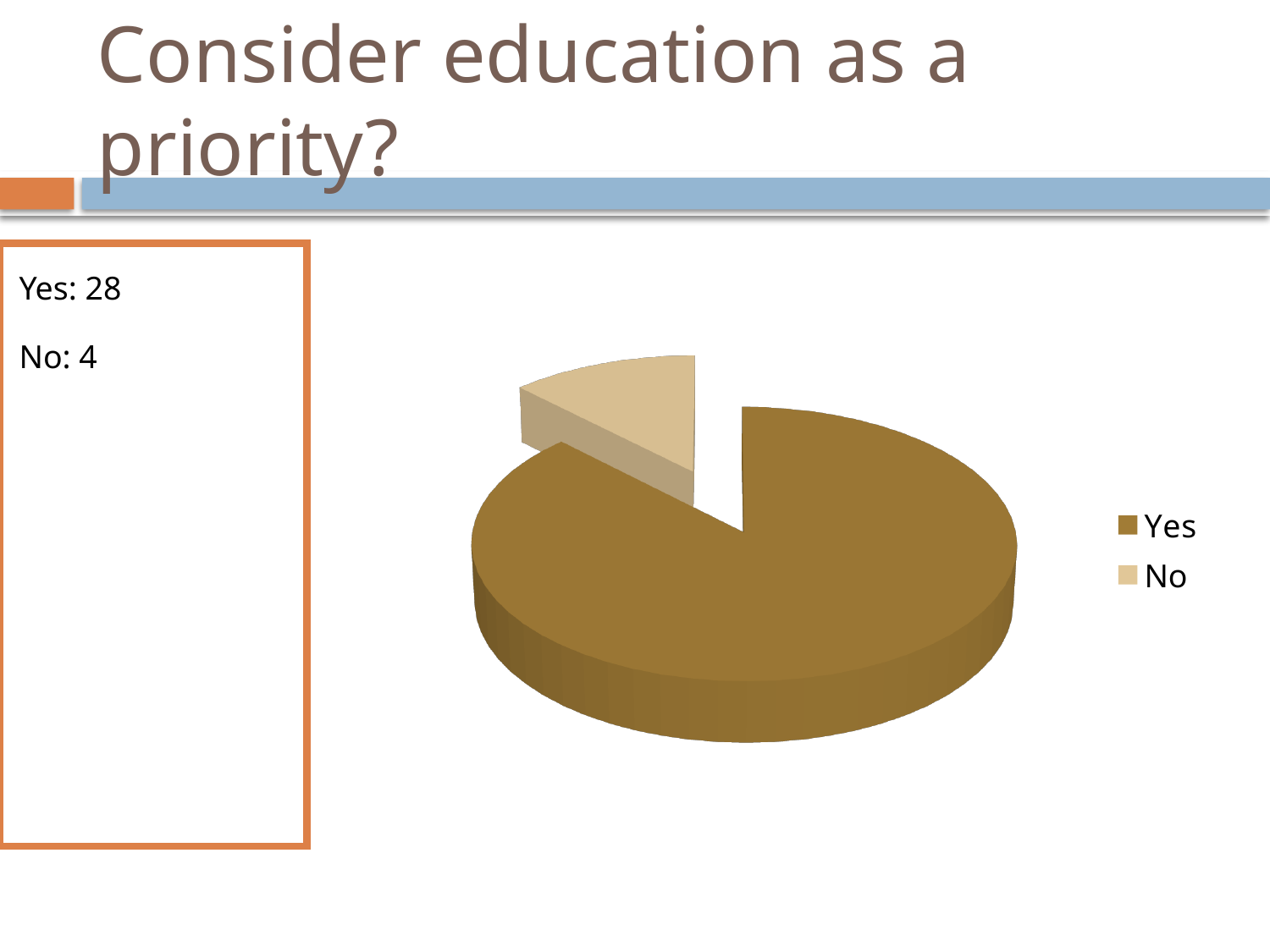
What is the title of the slide containing the pie chart? Consider education as a priority? Which category has the smallest slice of the pie chart? No How many slices does the pie chart have? 2 How many entries does the legend of the pie chart list? 2 What kind of chart is shown on the slide? pie chart Which is larger, the value for Yes or the value for No? Yes What is the value for Yes shown on the slide? 28 What is the value for No shown on the slide? 4 What is the difference between the value for Yes and the value for No? 24 Which category has the largest slice of the pie chart? Yes What share of the pie does the No slice represent? 12.5% What is the total of the values for Yes and No? 32